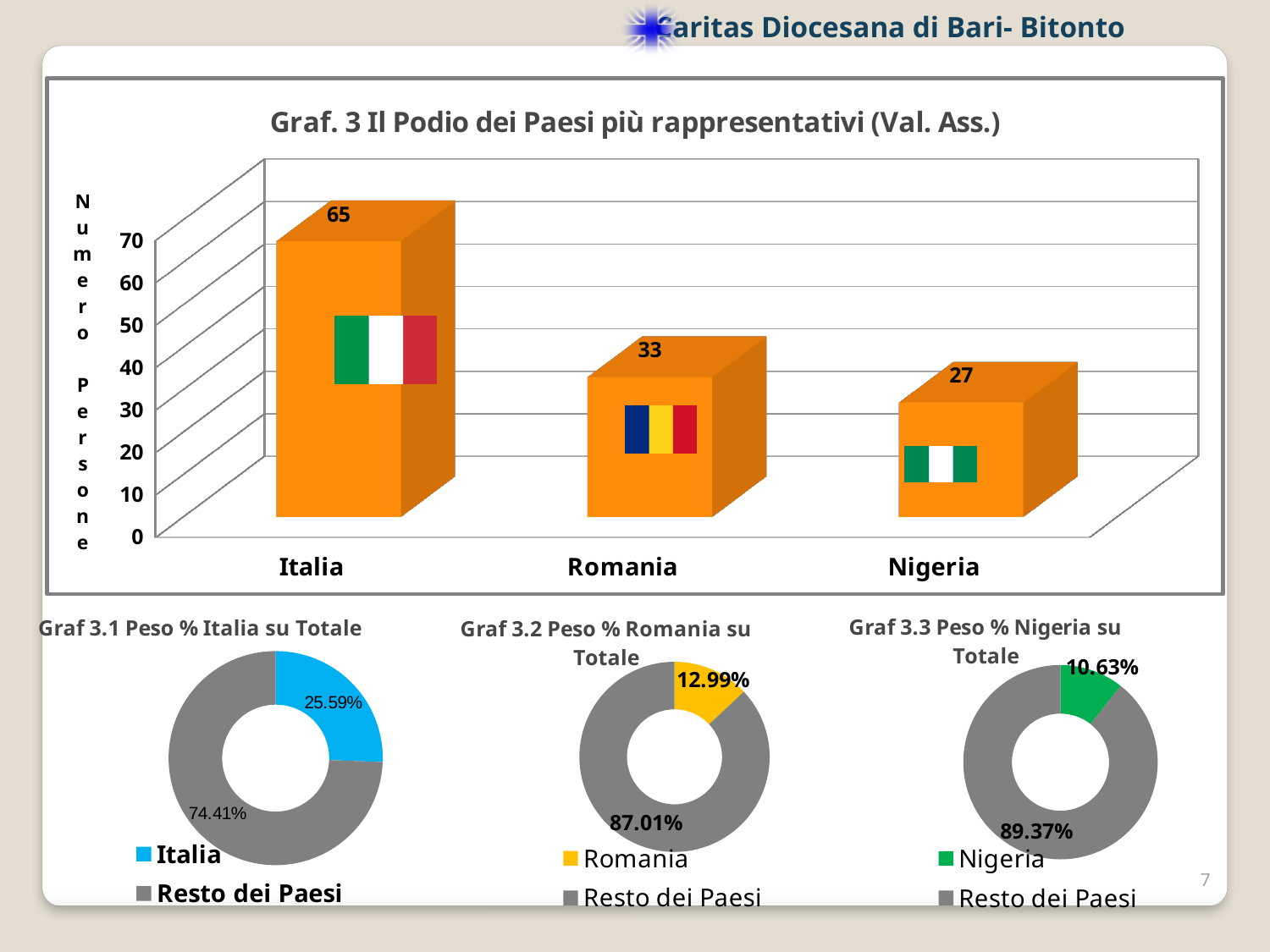
In the chart 'Graf. 3 Il Podio dei Paesi più rappresentativi (Val. Ass.)', which country has the lowest value? Nigeria In the chart 'Graf 3.2 Peso % Romania su Totale', what share does Resto dei Paesi have? 87.01% In the chart 'Graf. 3 Il Podio dei Paesi più rappresentativi (Val. Ass.)', how many countries are shown? 3 In the chart 'Graf. 3 Il Podio dei Paesi più rappresentativi (Val. Ass.)', what is the difference between the values for Italia and Romania? 32 In the chart 'Graf. 3 Il Podio dei Paesi più rappresentativi (Val. Ass.)', what is the value for Italia? 65 In the chart 'Graf. 3 Il Podio dei Paesi più rappresentativi (Val. Ass.)', do the values rise or fall from Italia to Nigeria? Fall What kind of chart is 'Graf. 3 Il Podio dei Paesi più rappresentativi (Val. Ass.)'? Bar chart In the chart 'Graf 3.1 Peso % Italia su Totale', what share does Italia have? 25.59% In the chart 'Graf. 3 Il Podio dei Paesi più rappresentativi (Val. Ass.)', what is the value for Romania? 33 In the chart 'Graf 3.3 Peso % Nigeria su Totale', what share does Nigeria have? 10.63% How many entries does the legend of the chart 'Graf 3.1 Peso % Italia su Totale' list? 2 In the chart 'Graf 3.3 Peso % Nigeria su Totale', which is larger, Nigeria or Resto dei Paesi? Resto dei Paesi